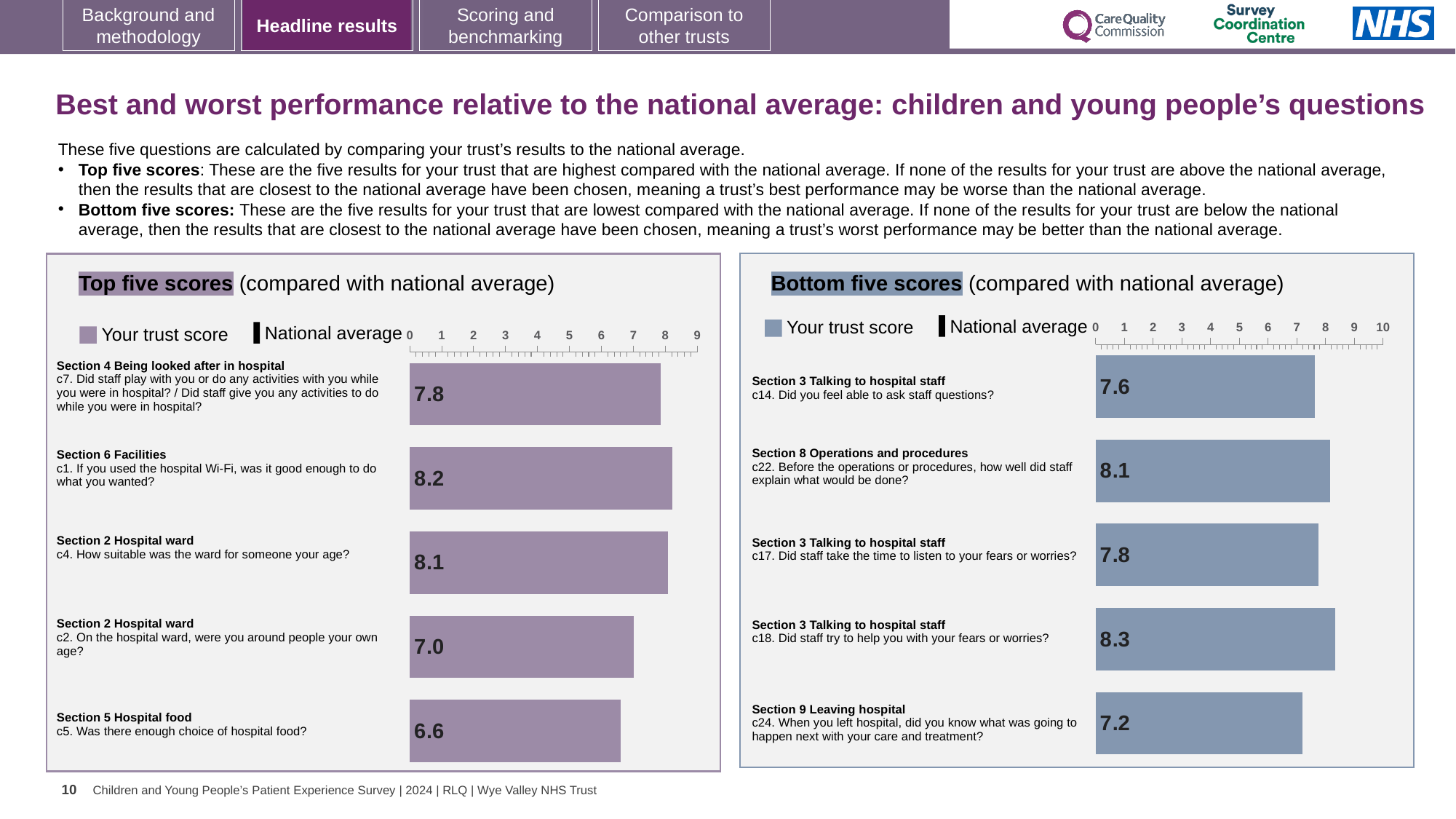
In the Bottom five scores chart, what is the trust score for c24 (When you left hospital, did you know what was going to happen next with your care and treatment?)? 7.2 What type of chart is the Bottom five scores chart? Bar chart In the Top five scores chart, what is the difference between the trust scores for c1 (hospital Wi-Fi) and c5 (choice of hospital food)? 1.6 In the Bottom five scores chart, which question has the lowest trust score? c24. When you left hospital, did you know what was going to happen next with your care and treatment? In the Bottom five scores chart, which has the larger trust score: c14 (Did you feel able to ask staff questions?) or c17 (Did staff take the time to listen to your fears or worries?)? c17 In the Top five scores chart, what is the trust score for c4 (How suitable was the ward for someone your age?)? 8.1 How many questions are plotted in the Top five scores chart? 5 How many entries does the legend of the Top five scores chart list? 2 In the Top five scores chart, which question has the highest trust score? c1. If you used the hospital Wi-Fi, was it good enough to do what you wanted? In the Top five scores chart, which question has the lowest trust score? c5. Was there enough choice of hospital food? In the Bottom five scores chart, which question has the highest trust score? c18. Did staff try to help you with your fears or worries? In the Top five scores chart, what is the trust score for c1 (If you used the hospital Wi-Fi, was it good enough to do what you wanted?)? 8.2